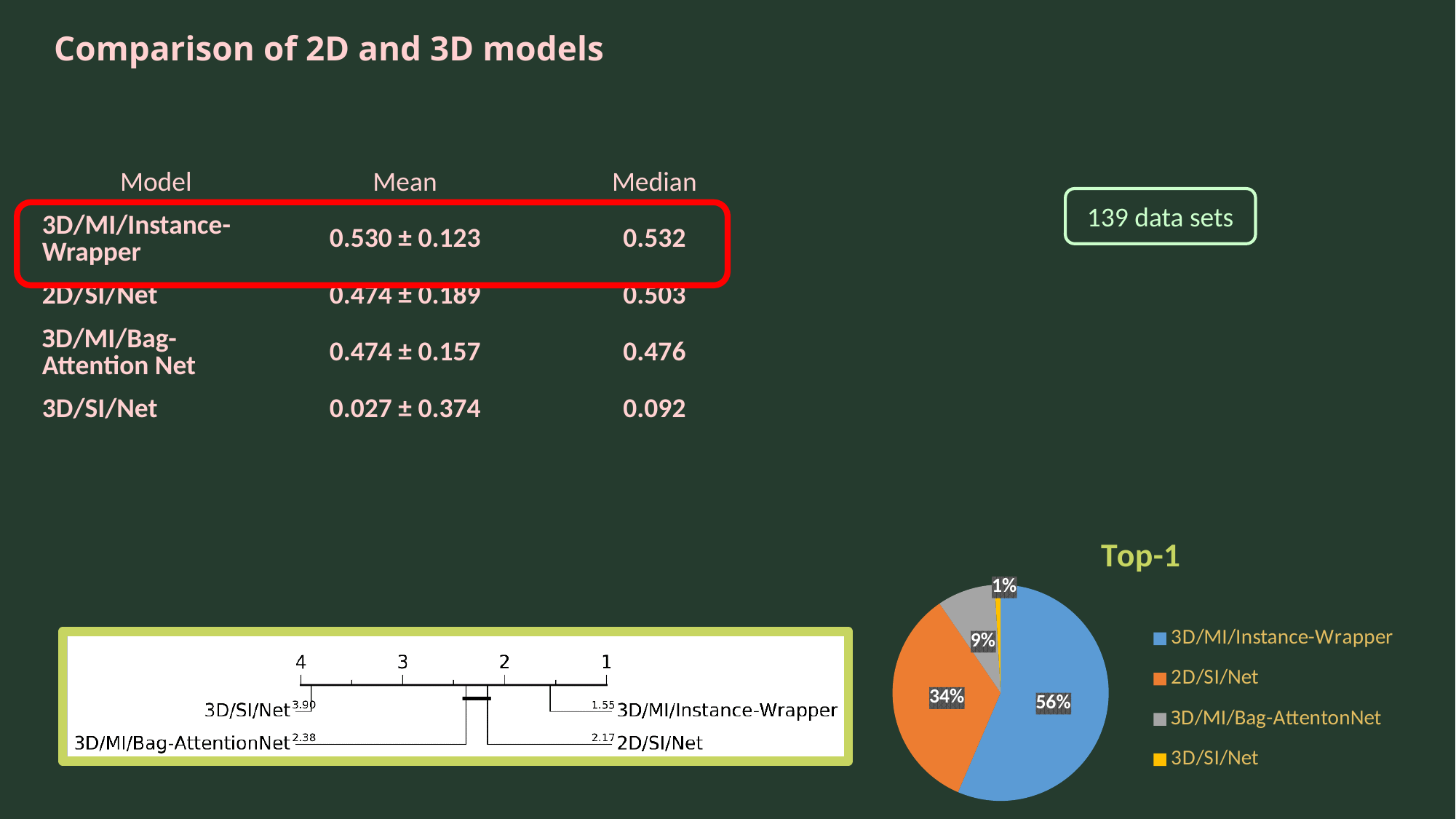
In the Top-1 pie chart, what share does 3D/MI/Bag-AttentonNet have? 9% In the Top-1 pie chart, which model has the largest slice? 3D/MI/Instance-Wrapper How many slices does the Top-1 pie chart have? 4 In the Top-1 pie chart, what share does 3D/SI/Net have? 1% What type of chart is the Top-1 chart? Pie chart In the Top-1 pie chart, which slice is larger: 2D/SI/Net or 3D/MI/Bag-AttentonNet? 2D/SI/Net In the Top-1 pie chart, what is the difference in percentage points between the 3D/MI/Instance-Wrapper slice and the 2D/SI/Net slice? 22 percentage points In the Top-1 pie chart, what colour is the 2D/SI/Net slice? Orange In the Top-1 pie chart, which model has the smallest slice? 3D/SI/Net In the Top-1 pie chart, what share does 3D/MI/Instance-Wrapper have? 56% In the ranking diagram at the bottom left of the slide, what average rank is shown for 3D/MI/Instance-Wrapper? 1.55 In the Top-1 pie chart, what share does 2D/SI/Net have? 34%